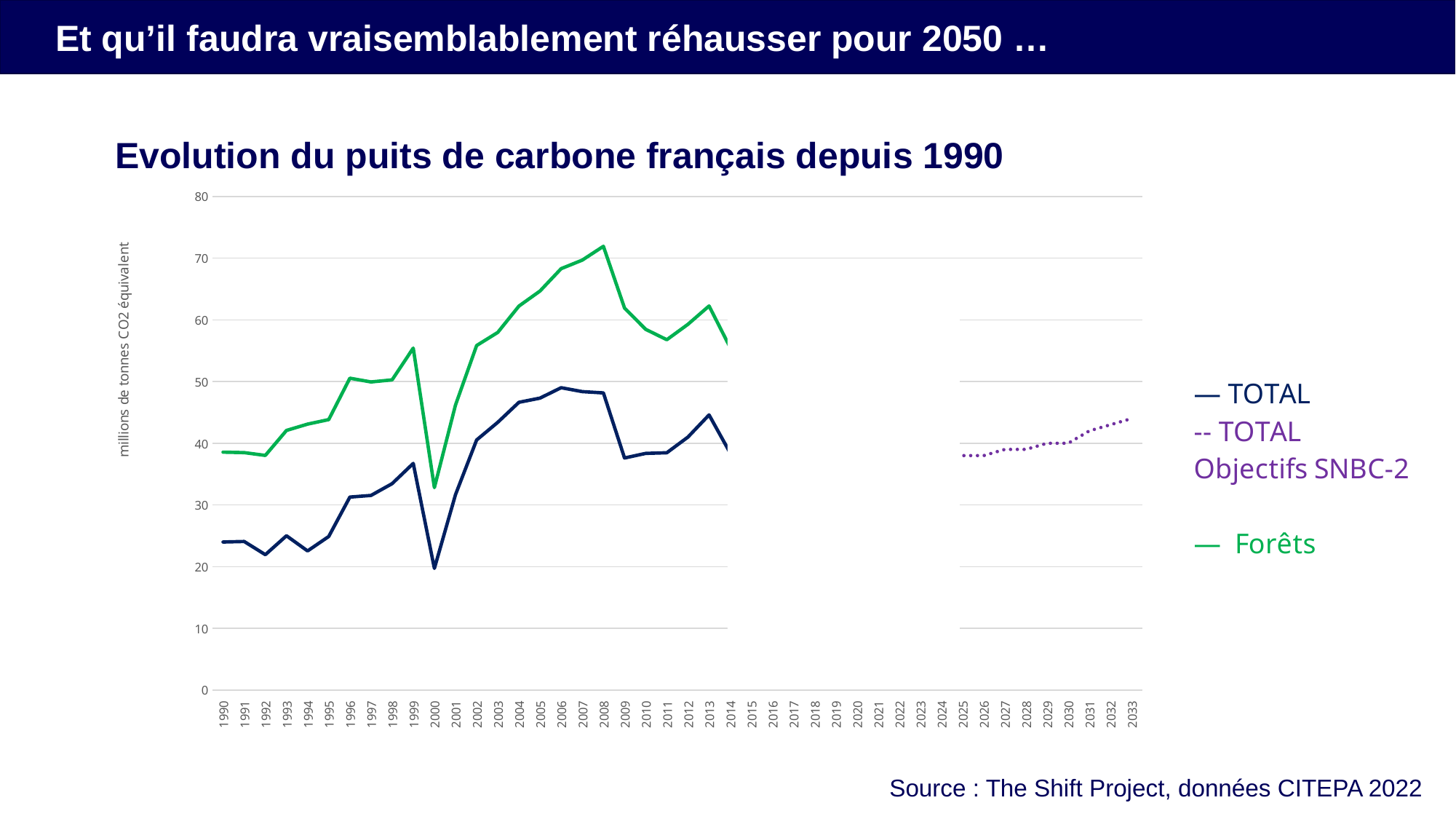
Is the value for TOTAL in 1990 greater or less than 30? less In which year does the Forêts series reach its highest value? 2008 In which year does the TOTAL series reach its lowest value? 2000 Is the value for TOTAL in 2000 greater or less than 30? less What kind of chart is shown on the slide? line chart Is the value for TOTAL Objectifs SNBC-2 in 2033 greater or less than 40? greater Does the Forêts series rise or fall between 2008 and 2011? fall In 2008, which is larger: the Forêts value or the TOTAL value? Forêts What is the title of the chart? Evolution du puits de carbone français depuis 1990 How many series does the legend list? 3 Does the TOTAL Objectifs SNBC-2 series rise or fall between 2025 and 2033? rise